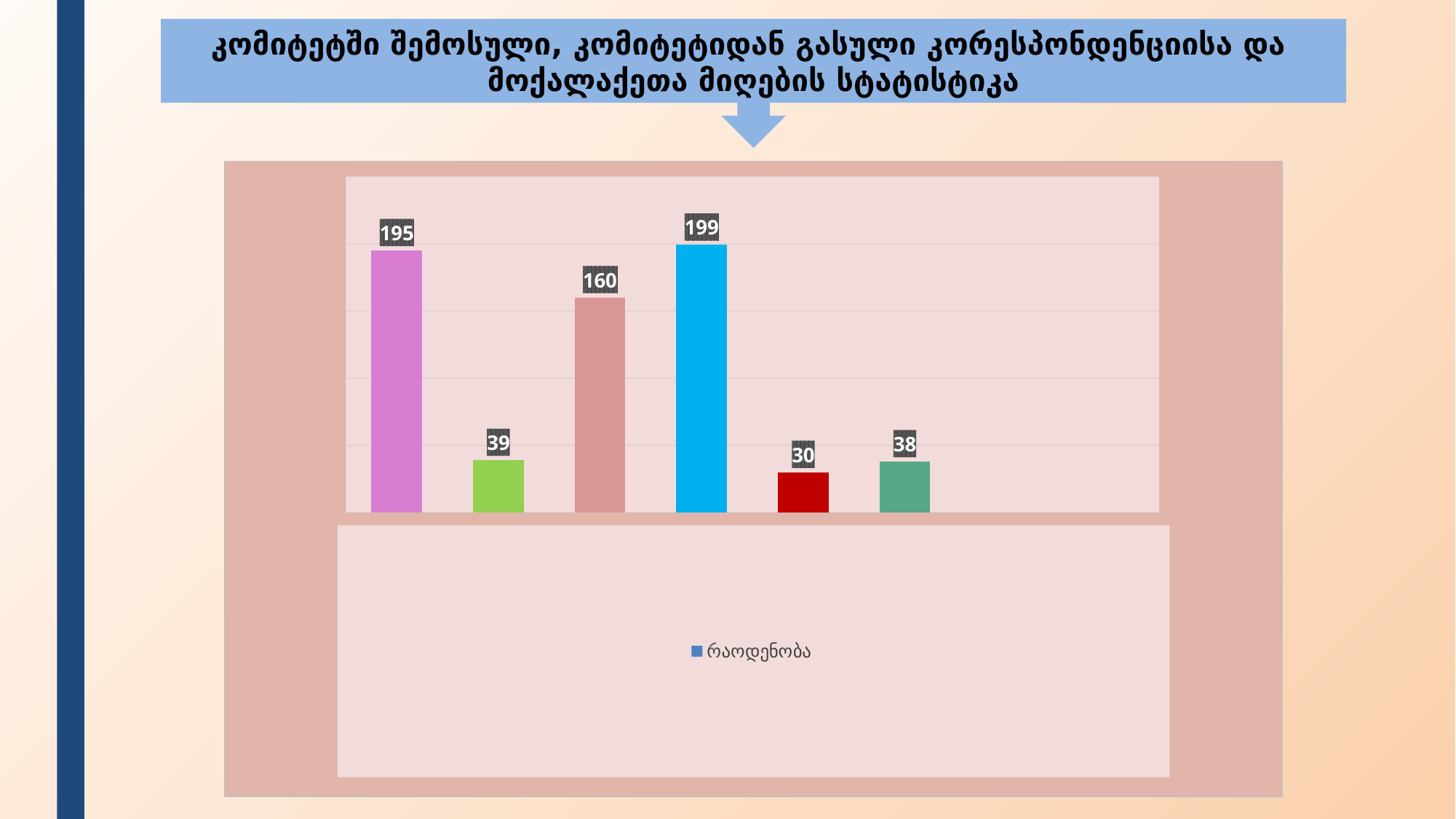
How many series does the chart legend list? 1 What value is labelled on the light blue bar (fourth from the left)? 199 What is the highest value labelled on any bar in the chart? 199 What value is labelled on the first (pink) bar from the left? 195 What is the difference between the fourth bar (199) and the first bar (195)? 4 What value is labelled on the green bar (second from the left)? 39 What is the difference between the first bar (195) and the second bar (39)? 156 What is the lowest value labelled on any bar in the chart? 30 What is the name of the series shown in the chart legend? რაოდენობა What kind of chart is shown on the slide? bar chart Which bar is taller: the third bar (160) or the fourth bar (199)? the fourth bar (199) How many bars are plotted in the chart? 6